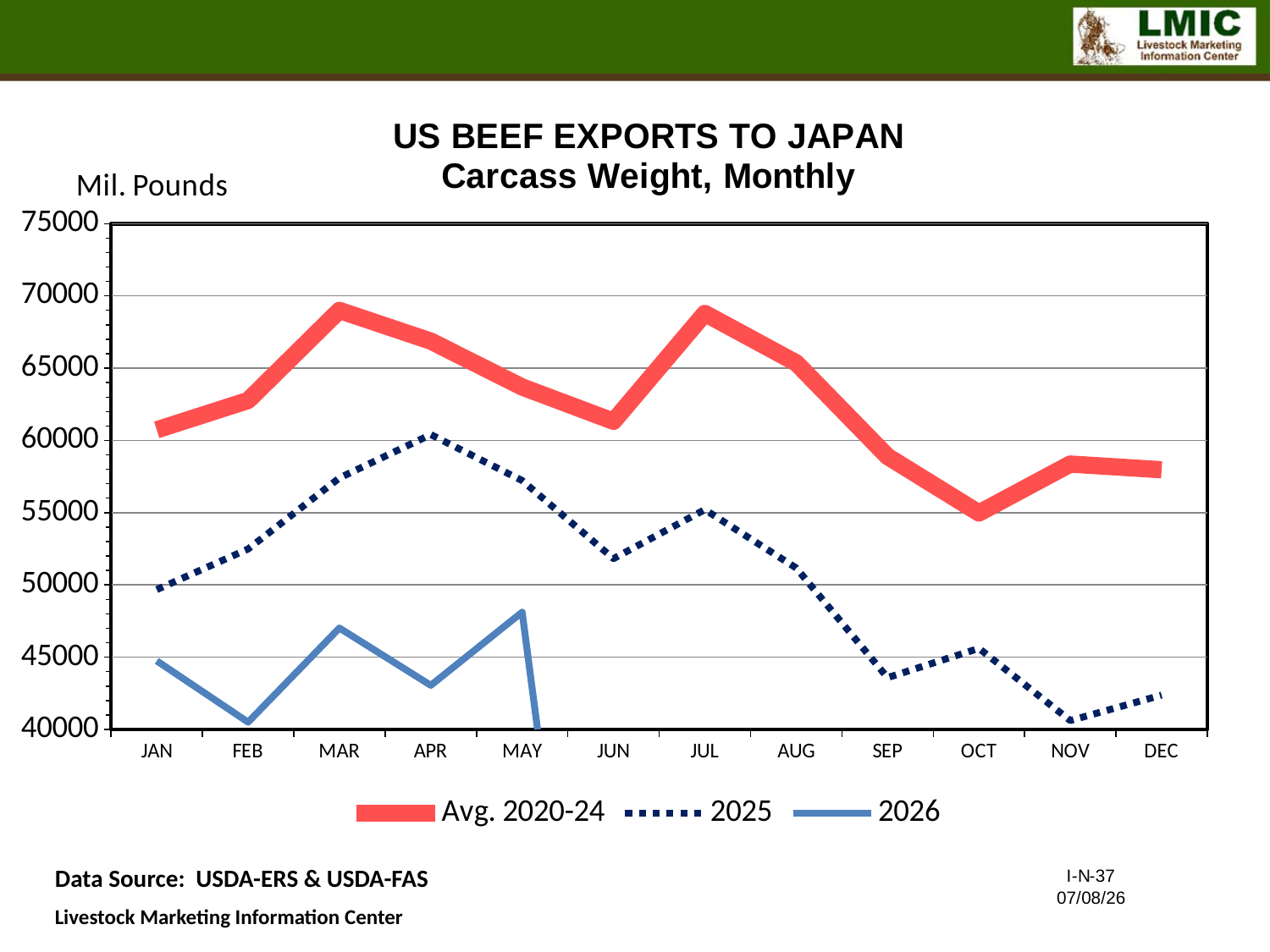
Is the 2025 value for JUN greater or less than 50000? greater How many months are shown along the x axis? 12 How many series does the legend list? 3 Is the 2025 value for SEP greater or less than 45000? less In APR, which series has the larger value, 2025 or 2026? 2025 Is the Avg. 2020-24 value for MAR greater or less than 65000? greater In which month does the 2025 series reach its highest value? APR What kind of chart is shown on the slide? line chart In which month is the 2025 series at its lowest? NOV Does the 2025 series rise or fall from APR to NOV? fall In which month is the Avg. 2020-24 series at its lowest? OCT